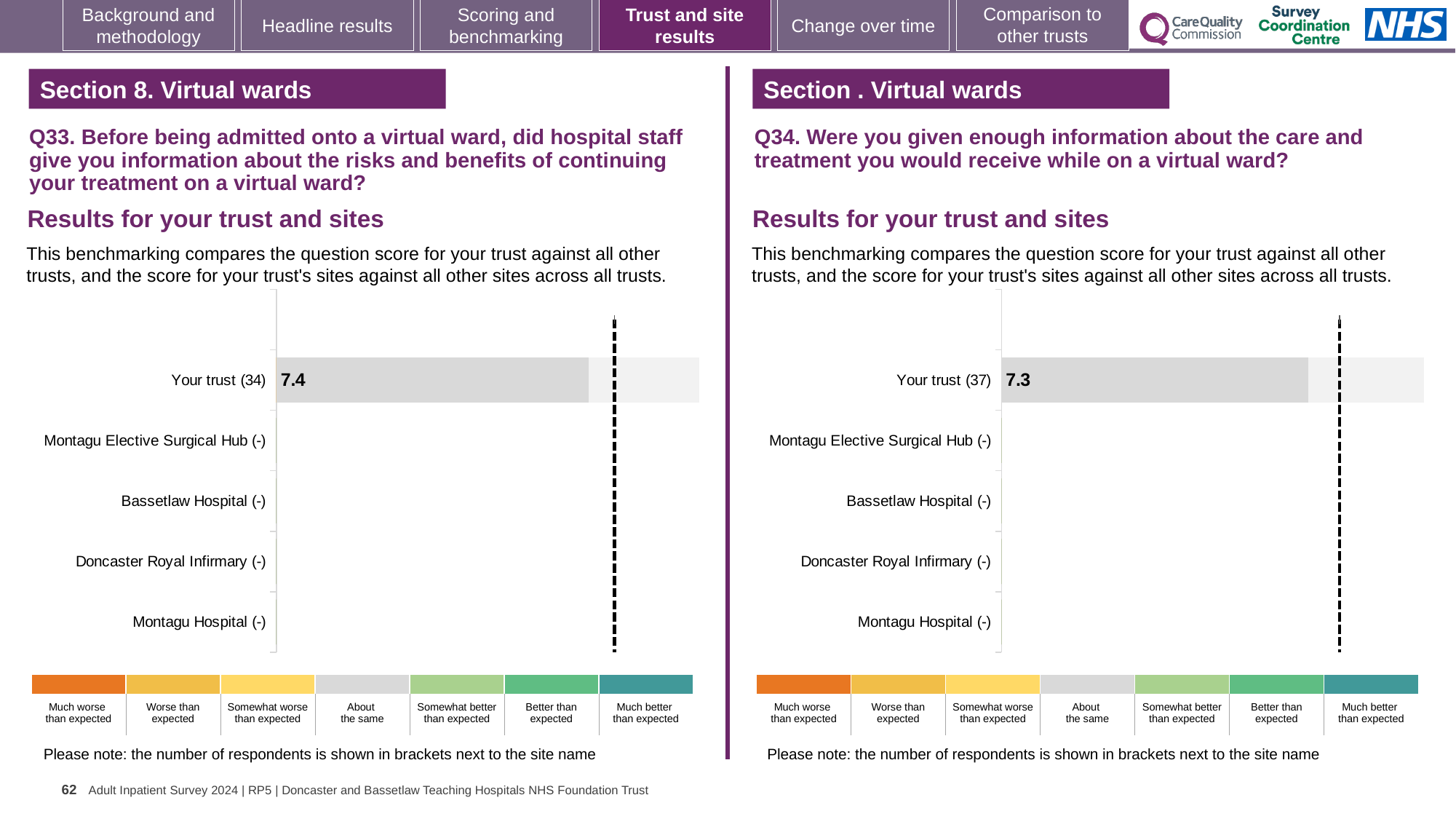
On the Q34 chart (right), which category is listed last on the vertical axis? Montagu Hospital (-) On the Q34 chart (right), how many respondents are shown in brackets next to Your trust? 37 On the Q33 chart (left), how many respondents are shown in brackets next to Your trust? 34 What kind of chart is the Q33 chart (left)? Bar chart On the Q33 chart (left), which category has a plotted bar? Your trust (34) On the Q34 chart (right), what is the score for Your trust? 7.3 On the Q34 chart (right), how many categories are listed on the vertical axis? 5 On the Q33 chart (left), what is the score for Your trust? 7.4 On the Q33 chart (left), how many categories are listed on the vertical axis? 5 What is the difference between the Your trust score on the Q33 chart (left) and the Your trust score on the Q34 chart (right)? 0.1 Is the Your trust score on the Q33 chart (left) larger or smaller than the Your trust score on the Q34 chart (right)? Larger On the Q34 chart (right), which category has a plotted bar? Your trust (37)